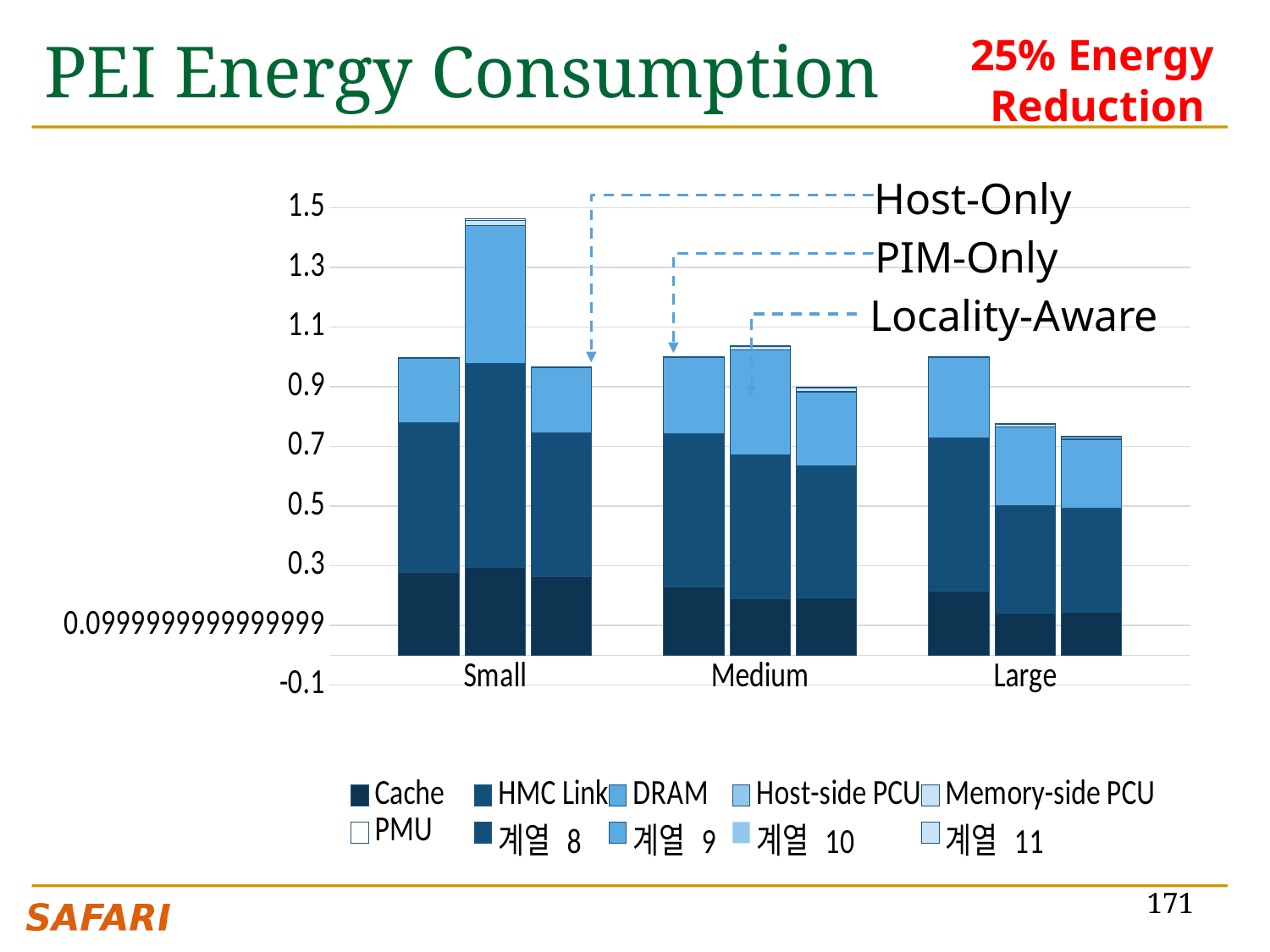
How many series does the chart's legend list? 10 Is the total of the PIM-Only bar for Large greater or less than 0.9? less What is the title of the chart on the slide? PEI Energy Consumption Is the total of the Locality-Aware bar for Large greater or less than 0.9? less For the Large category, which bar is taller: Host-Only or PIM-Only? Host-Only Which three bar configurations are labelled by the dashed arrows in the chart? Host-Only, PIM-Only, Locality-Aware Is the total of the PIM-Only bar for Medium greater or less than 0.9? greater For the Small category, which bar is taller: Host-Only or PIM-Only? PIM-Only What kind of chart is shown on the slide? Stacked bar chart Which category contains the tallest bar in the chart? Small How many categories are shown on the x axis of the chart? 3